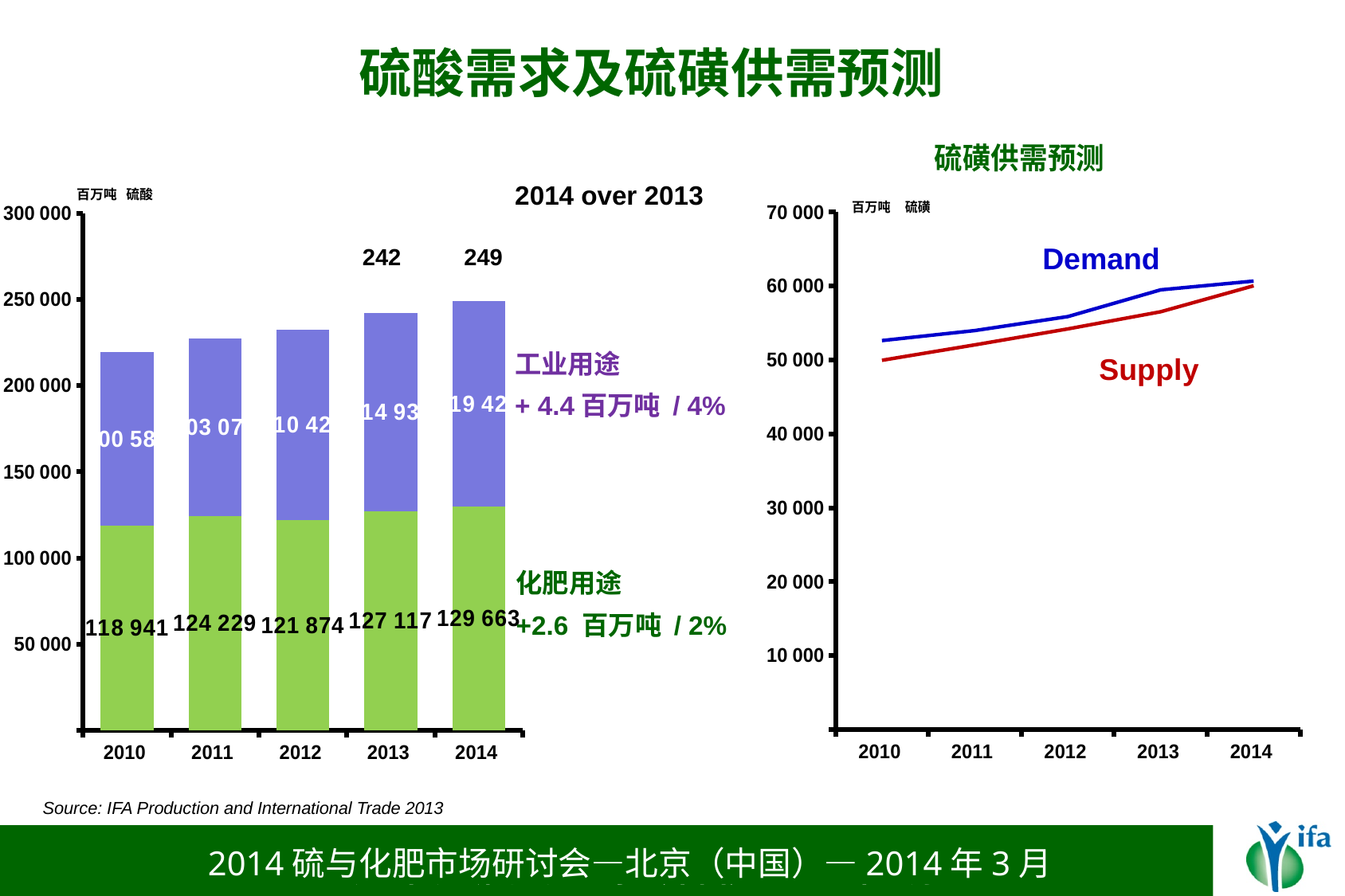
In the left bar chart, what is the difference between the 化肥用途 values for 2014 and 2013? 2 546 In the left bar chart, what total is printed above the 2014 bar? 249 What kind of chart is the 硫磺供需预测 chart on the right? Line chart How many years are shown on the x axis of the left bar chart? 5 In the 硫磺供需预测 chart, is the Demand value for 2010 greater or less than 50 000? greater What kind of chart is the chart on the left of the slide? Stacked bar chart In the left bar chart, which year has the highest 化肥用途 value? 2014 In the left bar chart, what is the value for 化肥用途 in 2010? 118 941 In the left bar chart, which year has the larger 化肥用途 value, 2011 or 2012? 2011 In the left bar chart, what is the value for 化肥用途 in 2014? 129 663 In the 硫磺供需预测 chart, does the Supply line rise or fall from 2010 to 2014? Rises In the left bar chart, which year has the lowest 化肥用途 value? 2010